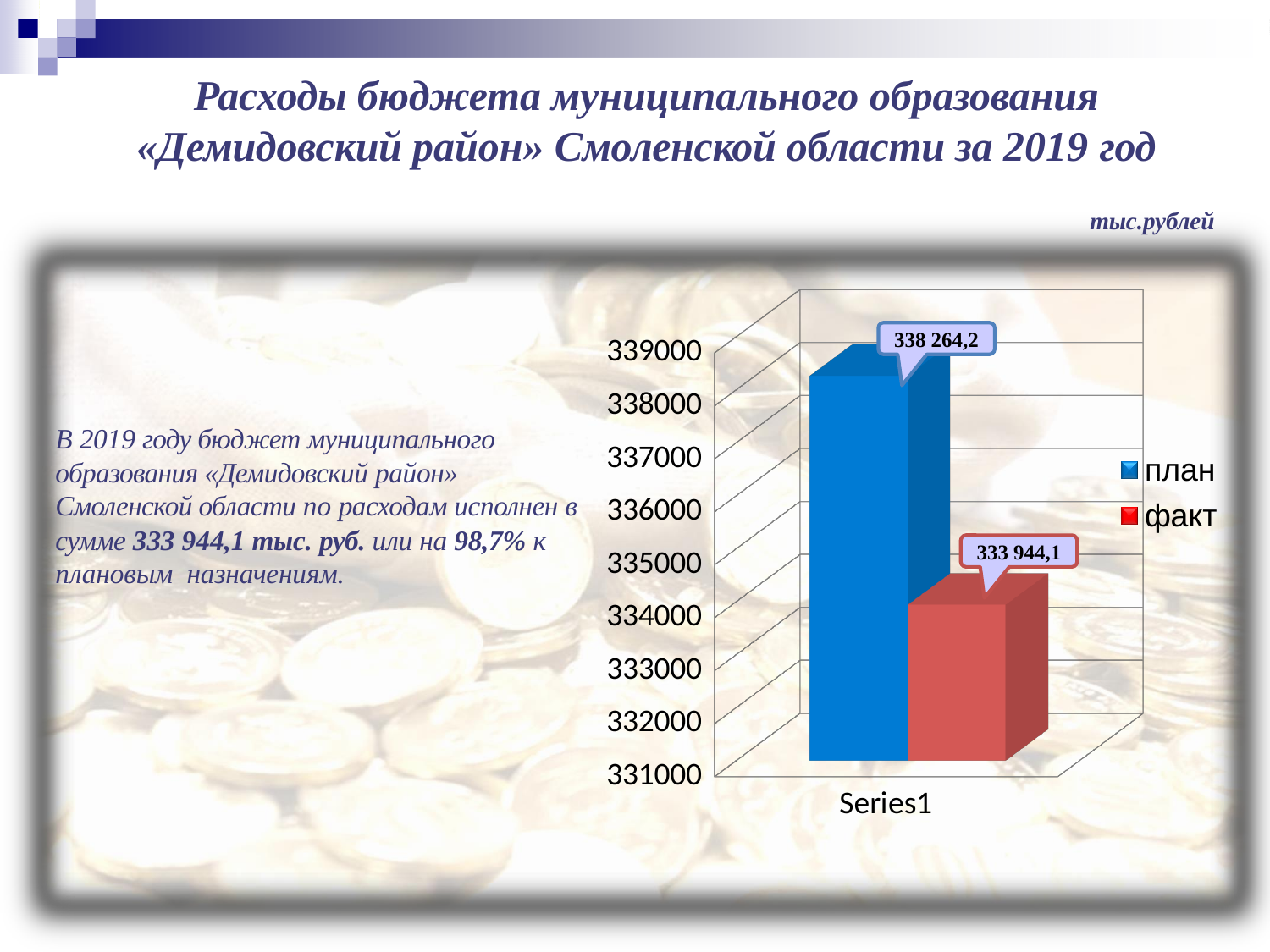
Which series has the lowest value? факт What is the value of the план (plan) bar? 338 264,2 How many bars are plotted in the chart? 2 Which series has the higher value, план or факт? план Is the value for факт greater or less than 335000? less What is the value of the факт (actual) bar? 333 944,1 What unit of measurement is indicated for the chart values? тыс.рублей What is the difference between the план and факт values? 4 320,1 What kind of chart is shown on the slide? bar chart How many series does the legend list? 2 What colour is the план bar? blue Is the value for план greater or less than 337000? greater